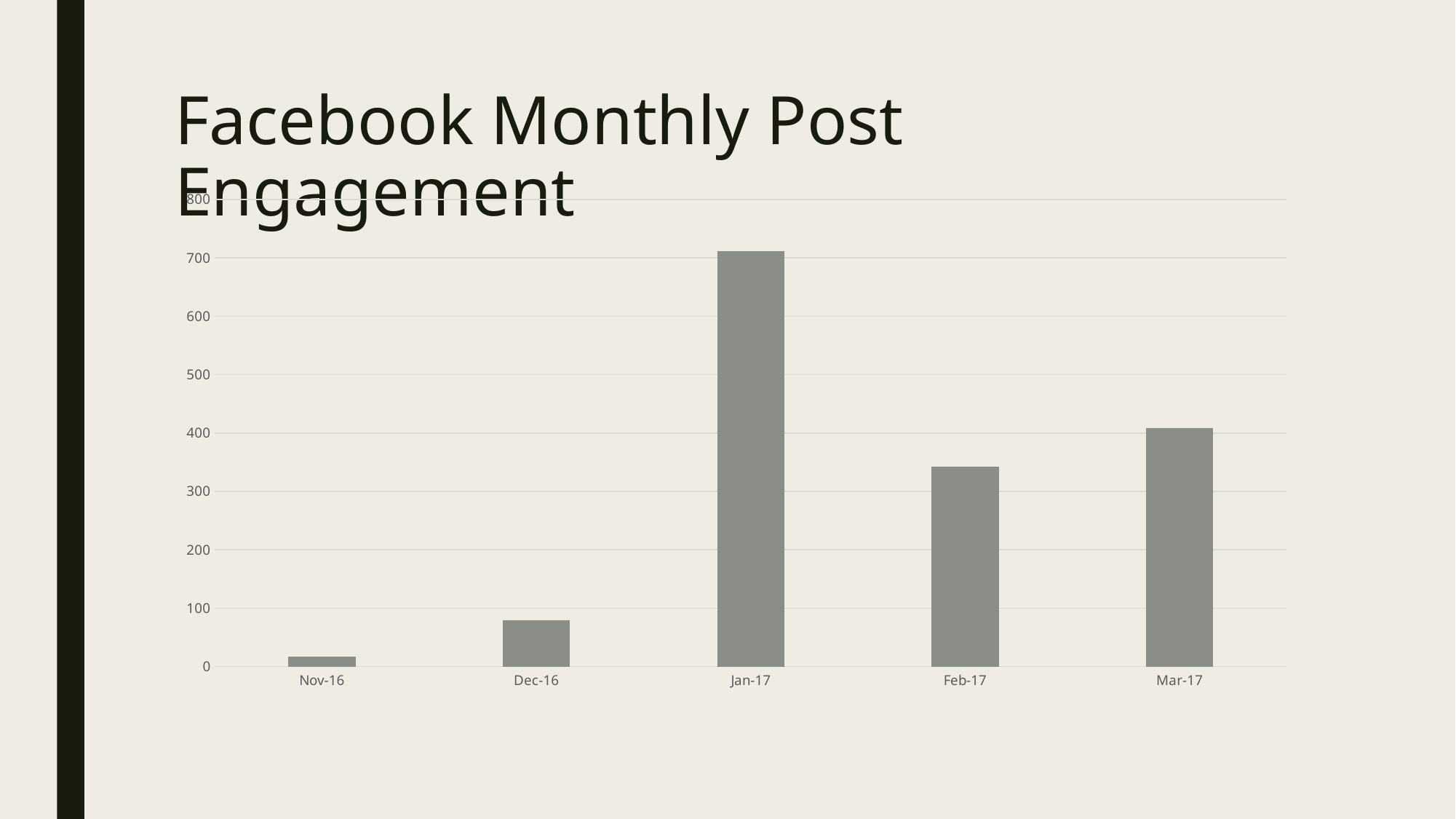
How many months are plotted on the x axis of the chart? 5 Which month has the highest bar in the chart? Jan-17 What is the title shown above the chart on the slide? Facebook Monthly Post Engagement Which month has the lowest bar in the chart? Nov-16 Which month has the larger value, Feb-17 or Mar-17? Mar-17 Which month has the larger value, Dec-16 or Feb-17? Feb-17 Is the value for Feb-17 greater or less than 400? less Is the value for Dec-16 greater or less than 100? less Is the value for Jan-17 greater or less than 600? greater Do the values rise or fall from Nov-16 to Jan-17? rise What kind of chart is shown on the slide? bar chart